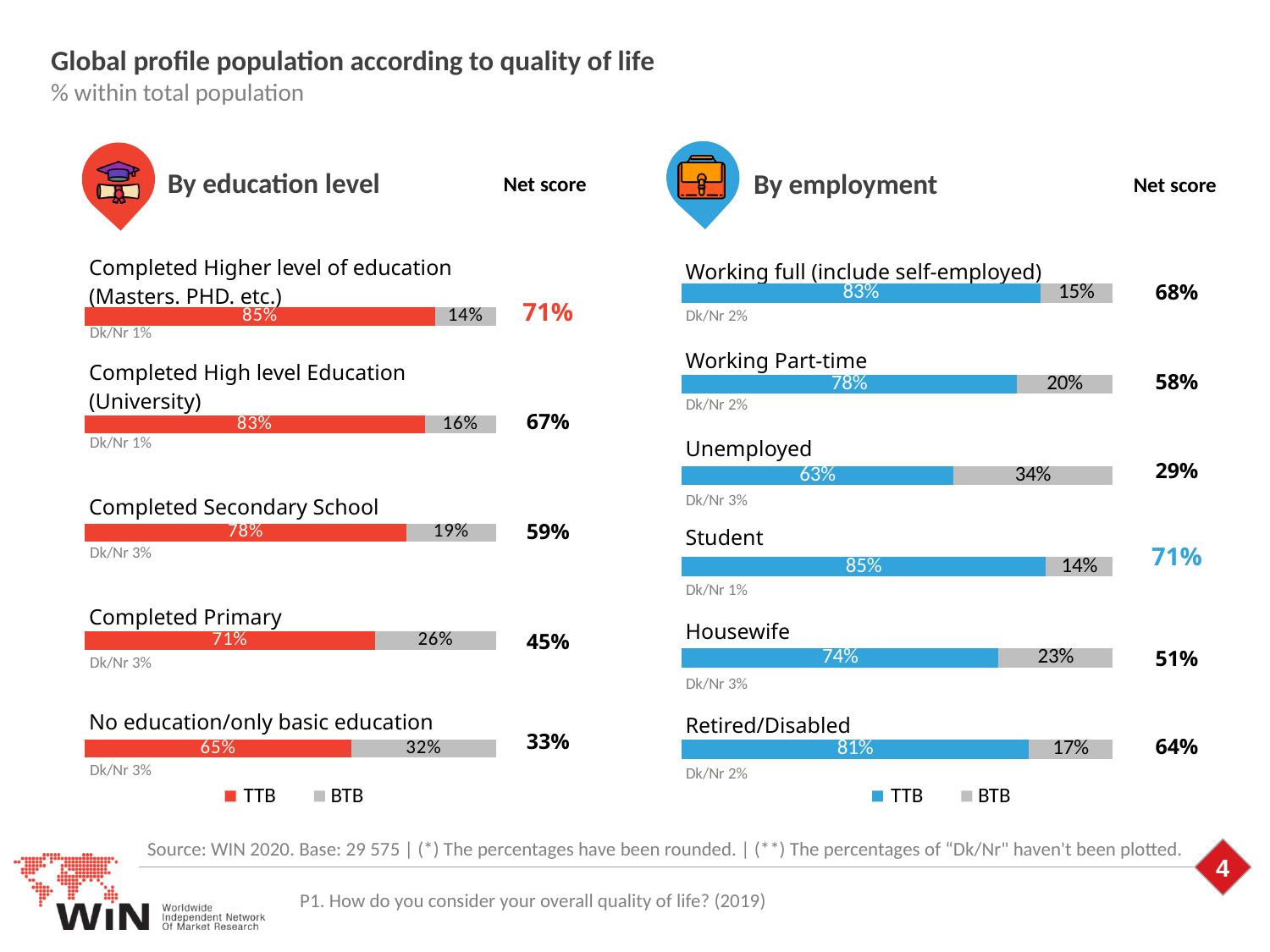
In the 'By education level' chart, which category has the lowest TTB value? No education/only basic education In the 'By employment' chart, which category has the highest TTB value? Student In the 'By education level' chart, what is the TTB value for Completed Secondary School? 78% In the 'By education level' chart, what is the difference between the TTB values for Completed Higher level of education (Masters, PHD, etc.) and Completed Primary? 14% In the 'By employment' chart, which is larger, the BTB value for Working Part-time or the BTB value for Retired/Disabled? Working Part-time In the 'By employment' chart, what is the TTB value for Unemployed? 63% In the 'By employment' chart, what is the total of the TTB and BTB values for Working full (include self-employed)? 98% In the 'By education level' chart, what is the BTB value for No education/only basic education? 32% In the 'By employment' chart, how many series does the legend list? 2 What kind of chart is the 'By education level' chart? Stacked bar chart In the 'By employment' chart, what is the BTB value for Housewife? 23% In the 'By education level' chart, how many education categories are shown? 5